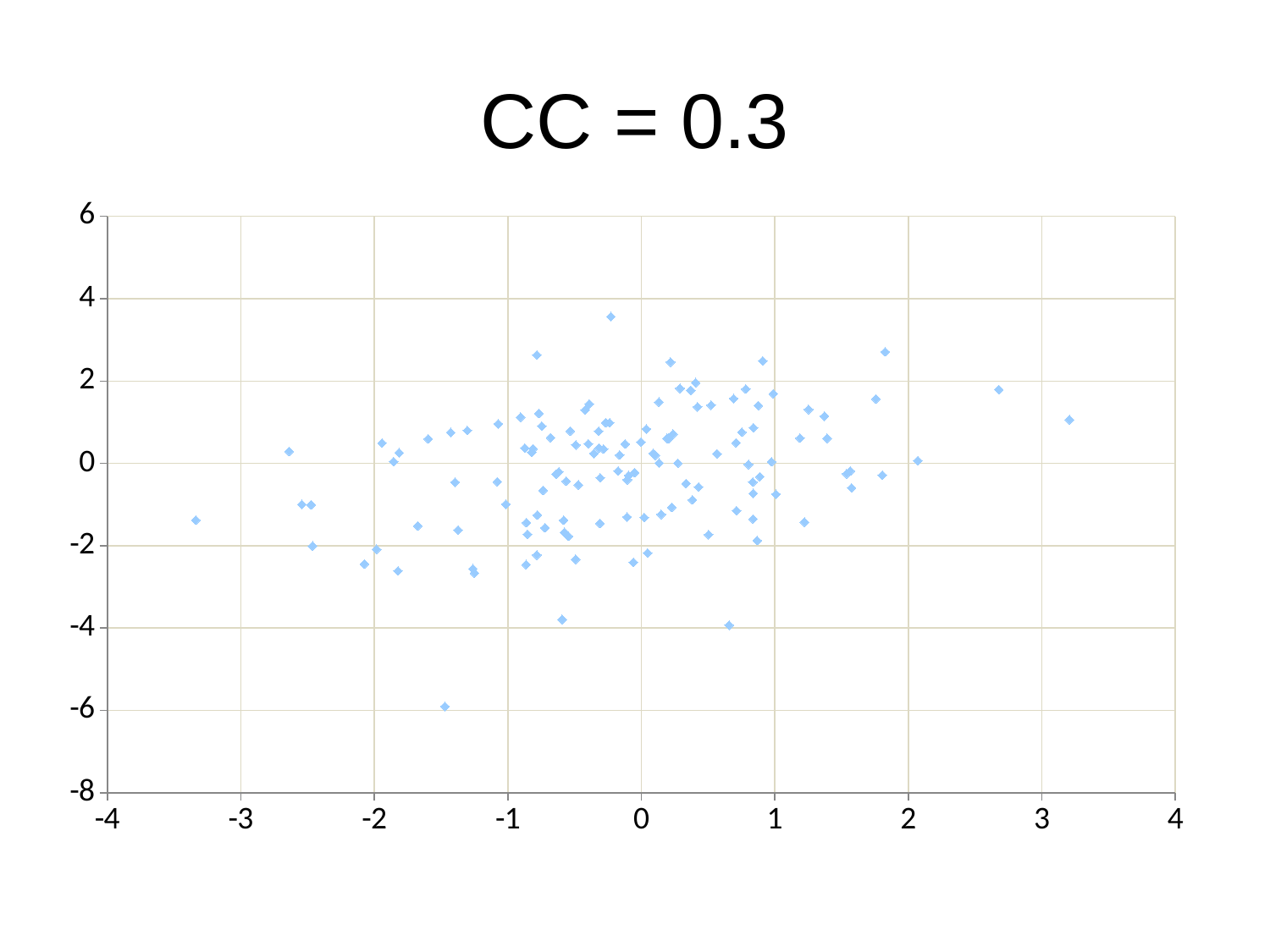
Is the y value of the highest plotted point greater or less than 4? less What kind of chart is shown on the slide? scatter chart Is the y value of the rightmost plotted point greater or less than 0? greater What is the lowest value shown on the y axis? -8 Is the x value of the leftmost plotted point greater or less than -3? less What is the title of the chart? CC = 0.3 Do the plotted y values tend to rise or fall as x increases? rise